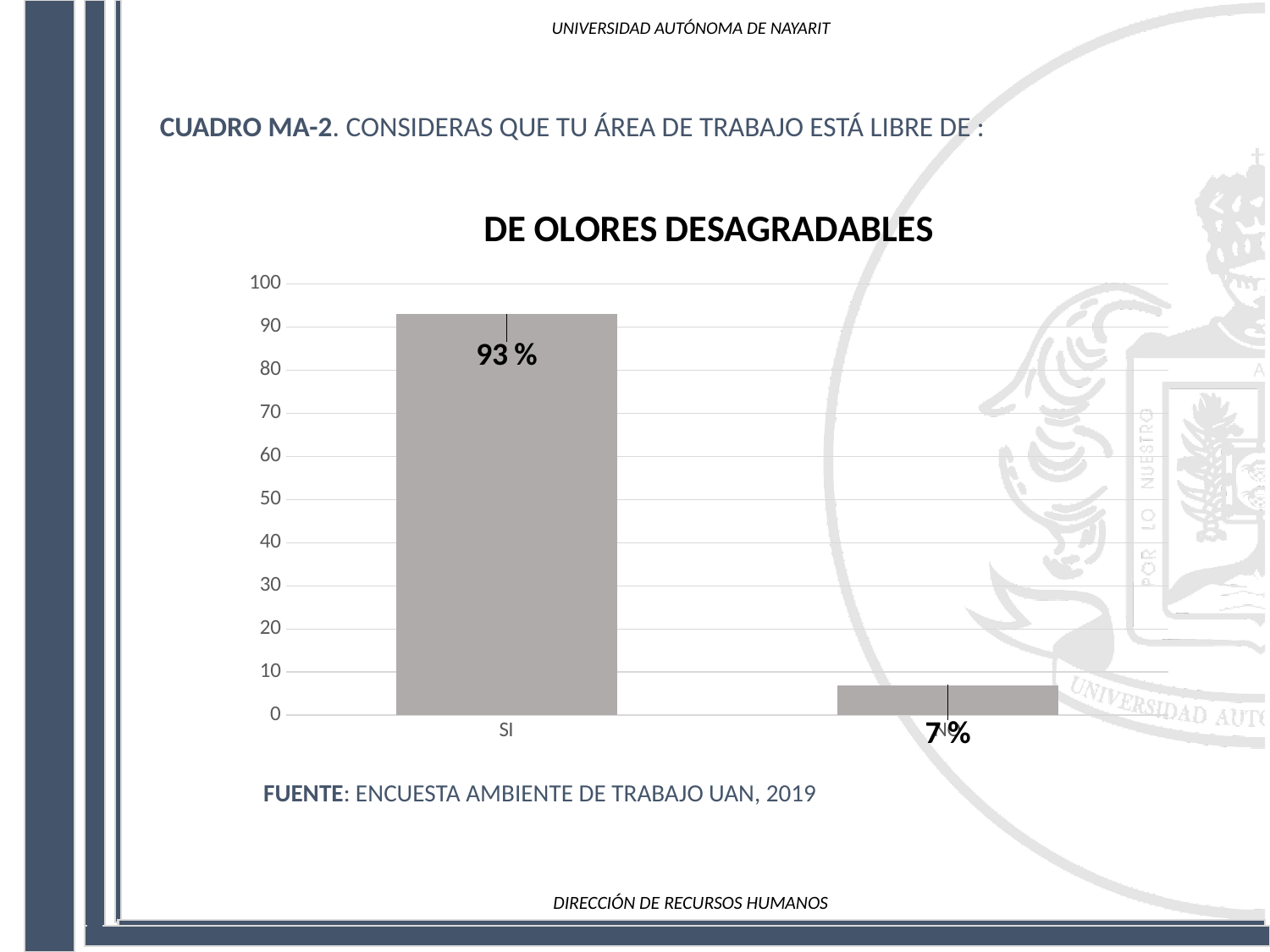
What type of chart is shown on the slide? bar chart What is the difference between the SI bar and the bar on the right? 86 % What is the value shown for the SI bar? 93 % Is the value for the bar on the right greater or less than 10? less Which category has the highest value? SI Which is larger, the SI bar or the bar on the right? SI What is the highest value shown on the vertical axis? 100 Do the values rise or fall from left to right across the chart? fall How many bars are plotted in the chart? 2 What is the value shown for the bar on the right of the chart? 7 % What is the chart's title? DE OLORES DESAGRADABLES Is the value for SI greater or less than 90? greater